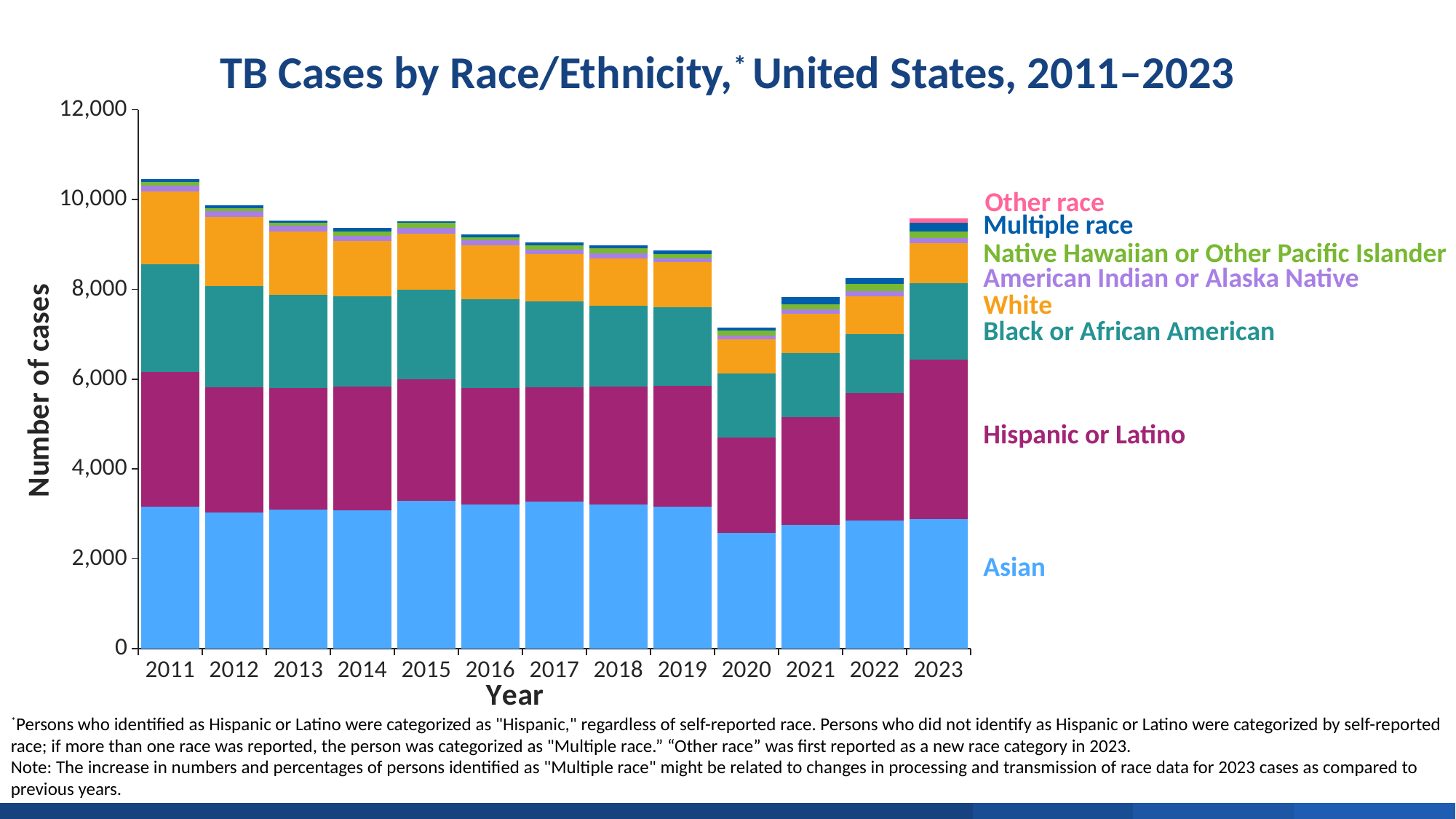
Which race/ethnicity series forms the bottom segment of each stacked bar? Asian Which year has the highest total number of TB cases? 2011 What kind of chart is shown on the slide? Stacked bar chart How many race/ethnicity series does the legend list? 8 Is the total number of cases in 2020 greater or less than 8,000? less Do the total TB cases generally rise or fall from 2011 to 2020? fall Is the number of Asian cases in 2020 greater or less than 3,000? less Which year has a larger total number of cases, 2020 or 2021? 2021 Which year has the lowest total number of TB cases? 2020 Is the total number of cases in 2011 greater or less than 10,000? greater How many years (bars) are plotted on the chart? 13